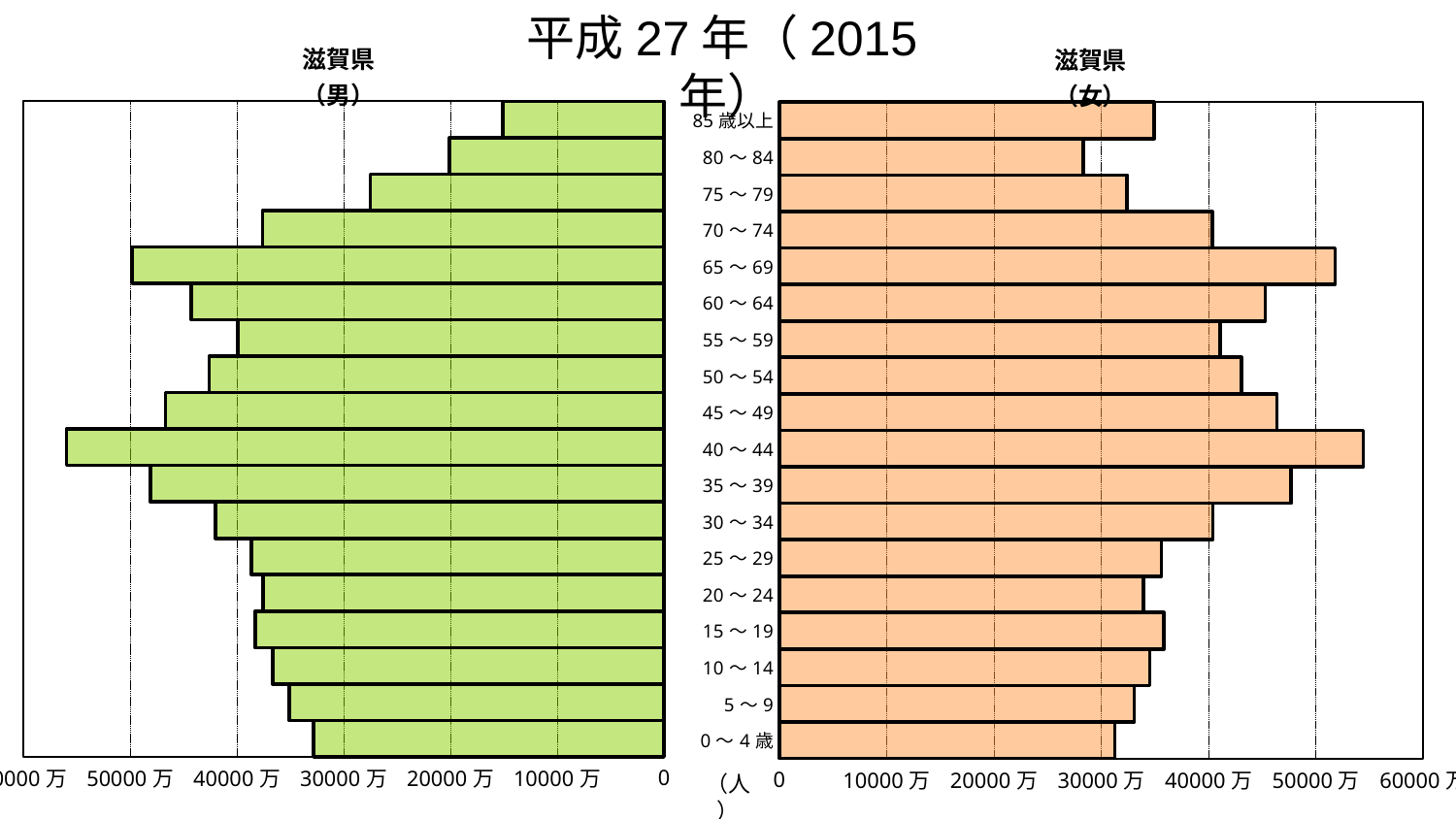
What is the title shown at the top of the slide? 平成27年（2015年） On the left chart (滋賀県（男）), is the value for 85歳以上 greater or less than 20000万? less On the left chart (滋賀県（男）), which is larger, the value for 65～69 or the value for 70～74? 65～69 On the right chart (滋賀県（女）), which is larger, the value for 35～39 or the value for 30～34? 35～39 How many age categories are shown on the right chart (滋賀県（女）)? 18 On the left chart (滋賀県（男）), is the value for 40～44 greater or less than 50000万? greater On the left chart (滋賀県（男）), which age group has the highest value? 40～44 On the right chart (滋賀県（女）), which age group has the highest value? 40～44 What kind of chart is the left chart (滋賀県（男）)? bar chart On the right chart (滋賀県（女）), is the value for 65～69 greater or less than 40000万? greater On the left chart (滋賀県（男）), which age group has the lowest value? 85歳以上 On the right chart (滋賀県（女）), which age group has the lowest value? 80～84